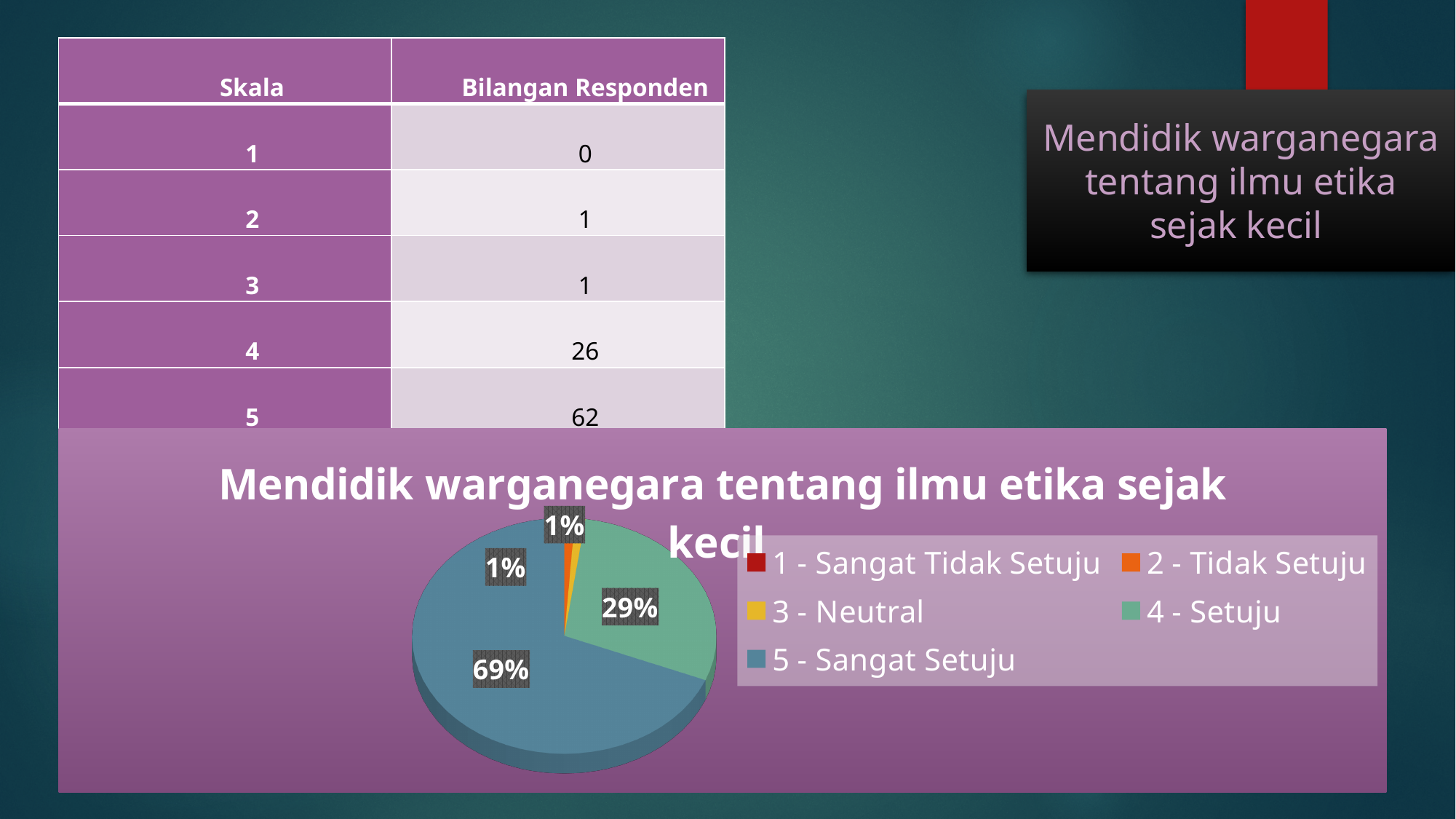
What share of the pie does 4 - Setuju take? 29% Which is larger, the slice for 4 - Setuju or the slice for 5 - Sangat Setuju? 5 - Sangat Setuju What kind of chart is shown on the slide? pie chart What share of the pie does 3 - Neutral take? 1% What is the title of the pie chart? Mendidik warganegara tentang ilmu etika sejak kecil What share of the pie does 5 - Sangat Setuju take? 69% What is the difference in percentage points between the 5 - Sangat Setuju slice and the 4 - Setuju slice? 40 How many entries does the legend of the pie chart list? 5 What colour is the slice for 5 - Sangat Setuju in the pie chart? blue Which category has the largest slice of the pie? 5 - Sangat Setuju